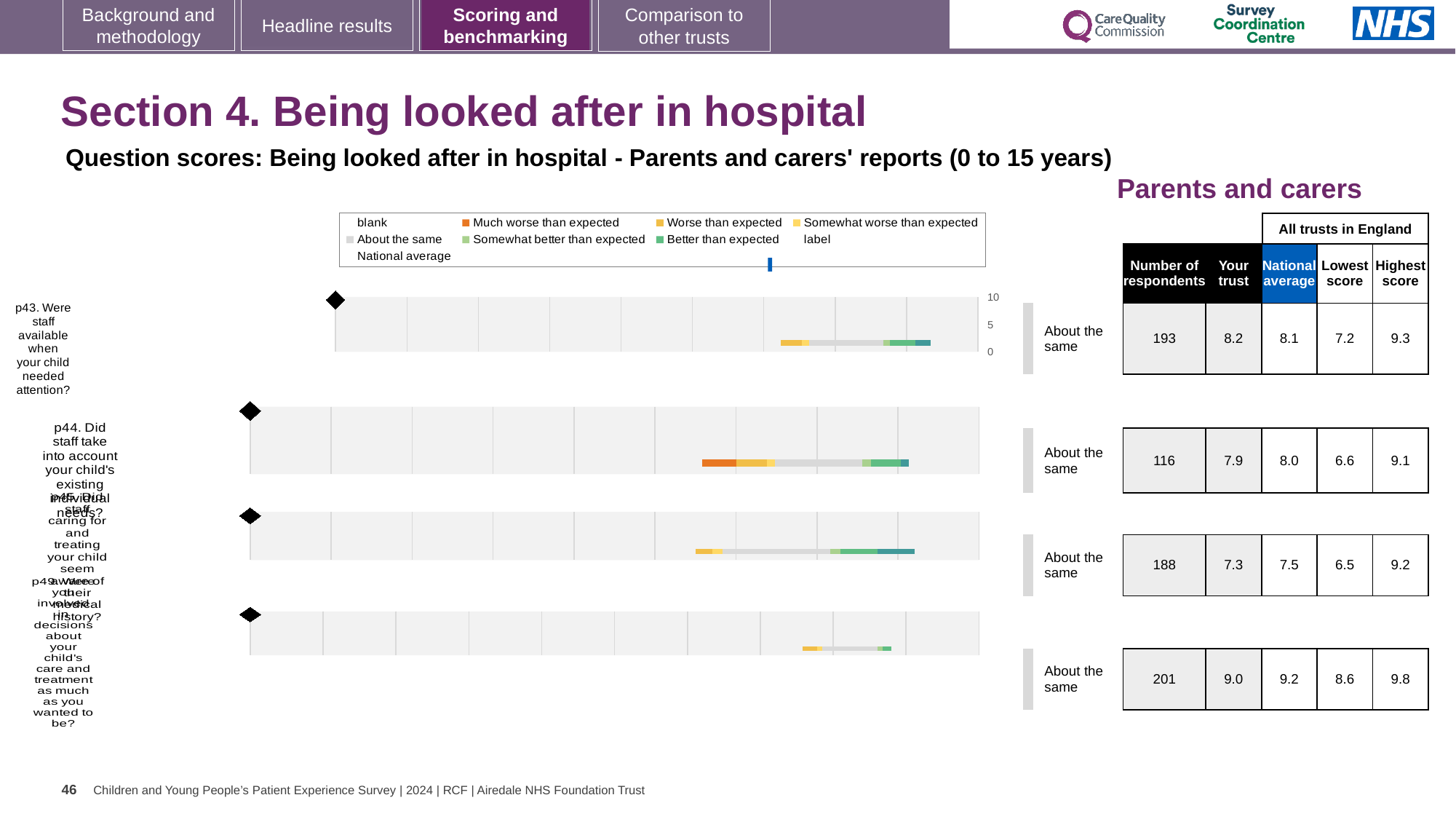
What is the number of respondents shown for p43 (Were staff available when your child needed attention?)? 193 What is the 'Your trust' score shown for p44 (Did staff take into account your child's existing individual needs?)? 7.9 Which question has the lowest 'Your trust' score? p45 What kind of chart is used to show the question scores on this slide? Bar chart For p44, what is the difference between the highest score and the lowest score across all trusts in England? 2.5 What is the highest score shown for p49 (Were you involved in decisions about your child's care and treatment as much as you wanted to be?)? 9.8 Which question has the highest 'Your trust' score? p49 For p43, which is larger: the 'Your trust' score or the national average? Your trust What is the national average shown for p45 (Did staff caring for and treating your child seem aware of their medical history?)? 7.5 What benchmark category label is shown next to each of the four question charts? About the same How many questions (p43, p44, p45, p49) are plotted on the slide? 4 Which question has the largest number of respondents? p49